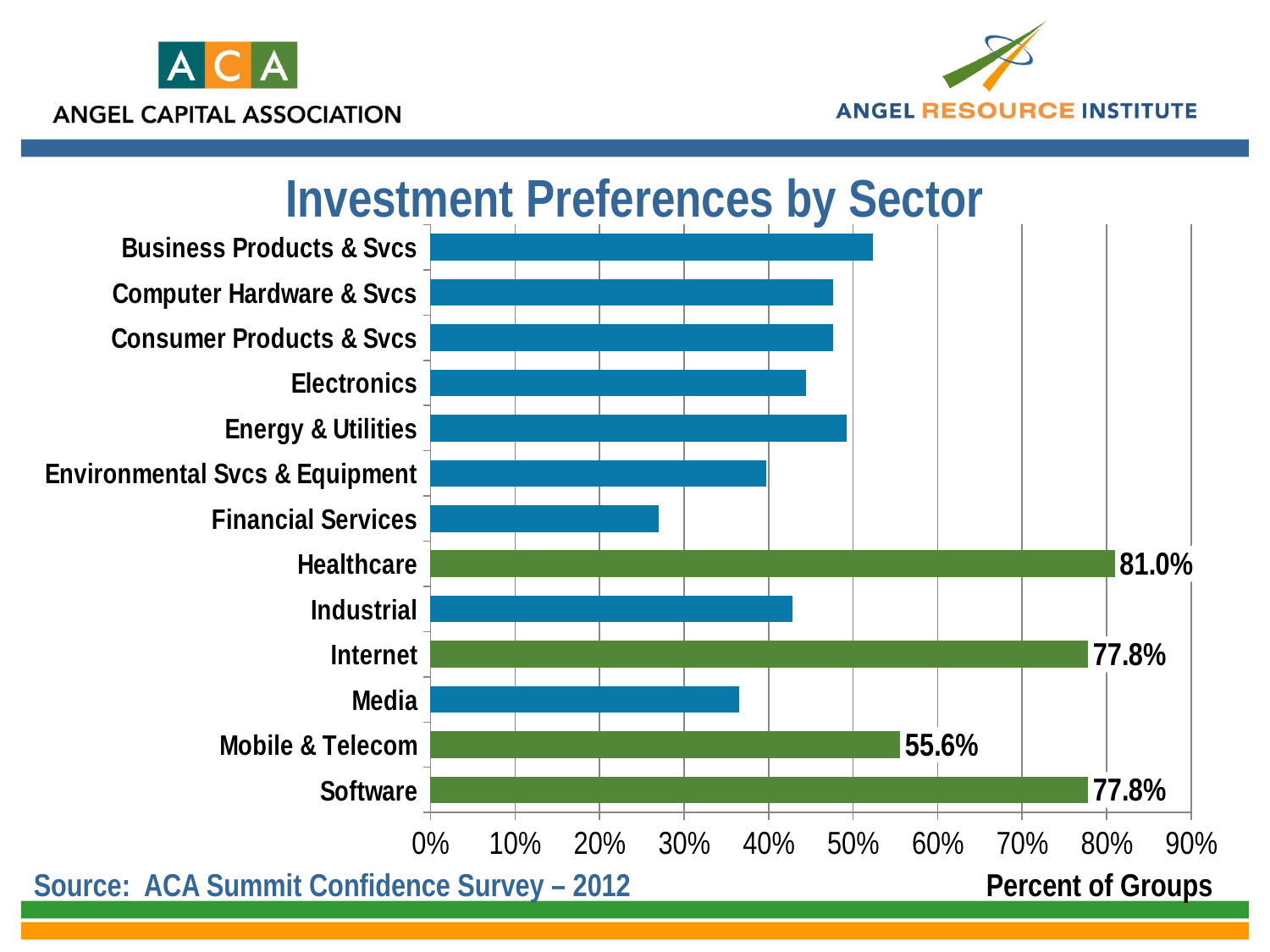
What is the value for Healthcare? 81.0% Is the value for Media greater or less than 40%? less What kind of chart is shown on the slide? bar chart What is the difference between the values for Healthcare and Internet? 3.2% What is the value for Software? 77.8% What is the value for Mobile & Telecom? 55.6% Which sector has the highest value? Healthcare How many sectors are shown in the chart? 13 Which is larger, the value for Internet or the value for Mobile & Telecom? Internet Which sector has the lowest value? Financial Services What is the difference between the values for Healthcare and Mobile & Telecom? 25.4% Is the value for Financial Services greater or less than 30%? less